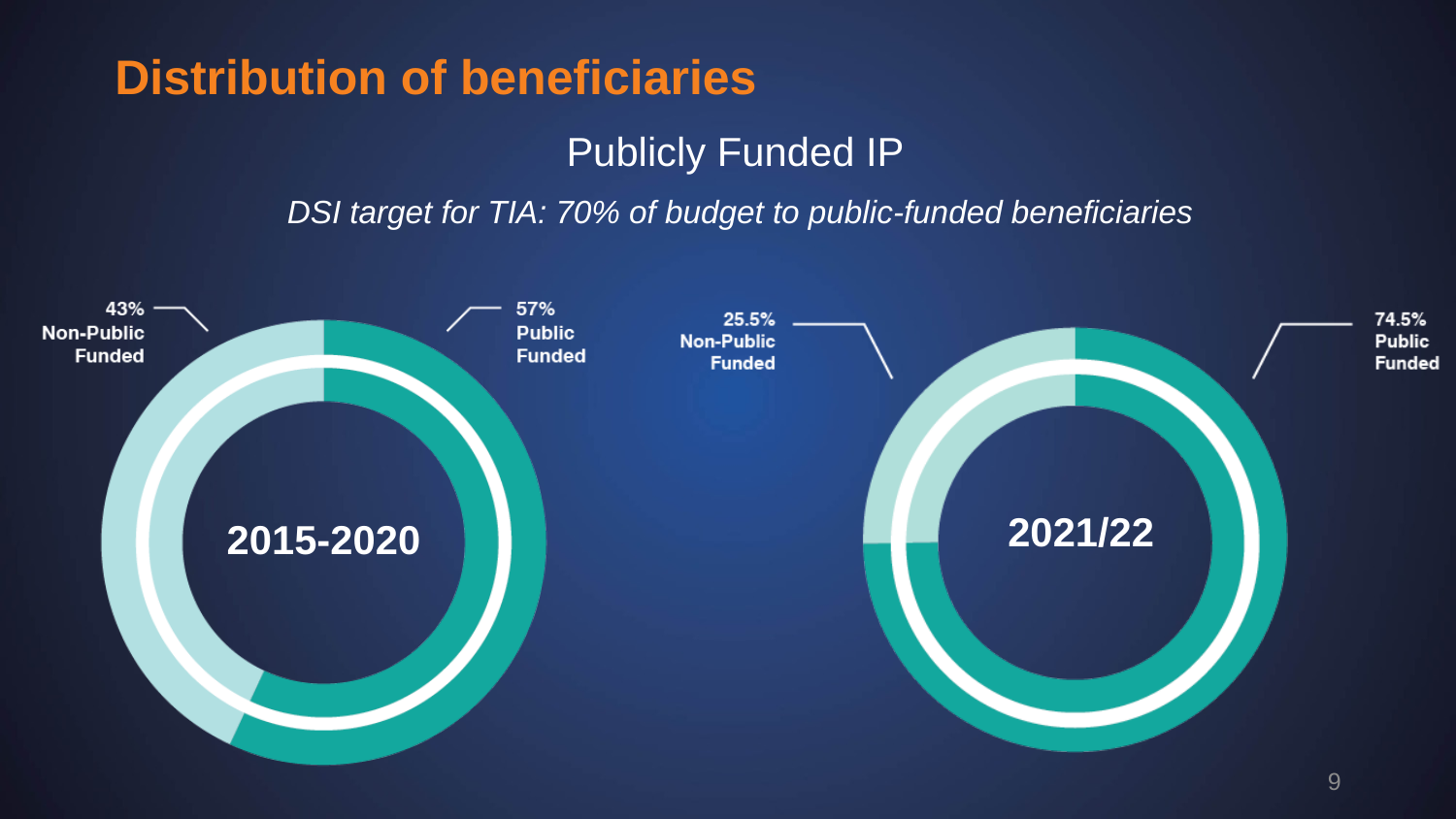
Is the Public Funded share larger in the 2015-2020 chart or the 2021/22 chart? 2021/22 In the 2021/22 chart, what is the difference between the Public Funded and Non-Public Funded shares? 49% In the 2021/22 chart, what share of beneficiaries is Non-Public Funded? 25.5% In the 2015-2020 chart, what share of beneficiaries is Non-Public Funded? 43% What is the title of the slide containing the charts? Distribution of beneficiaries In the 2015-2020 chart, what share of beneficiaries is Public Funded? 57% What kind of chart is used on this slide? Doughnut (pie) chart In the 2015-2020 chart, what is the difference between the Public Funded and Non-Public Funded shares? 14% In the 2015-2020 chart, which category has the larger share? Public Funded In the 2021/22 chart, what share of beneficiaries is Public Funded? 74.5% How many categories does each doughnut chart show? 2 In the 2021/22 chart, which category has the smaller share? Non-Public Funded